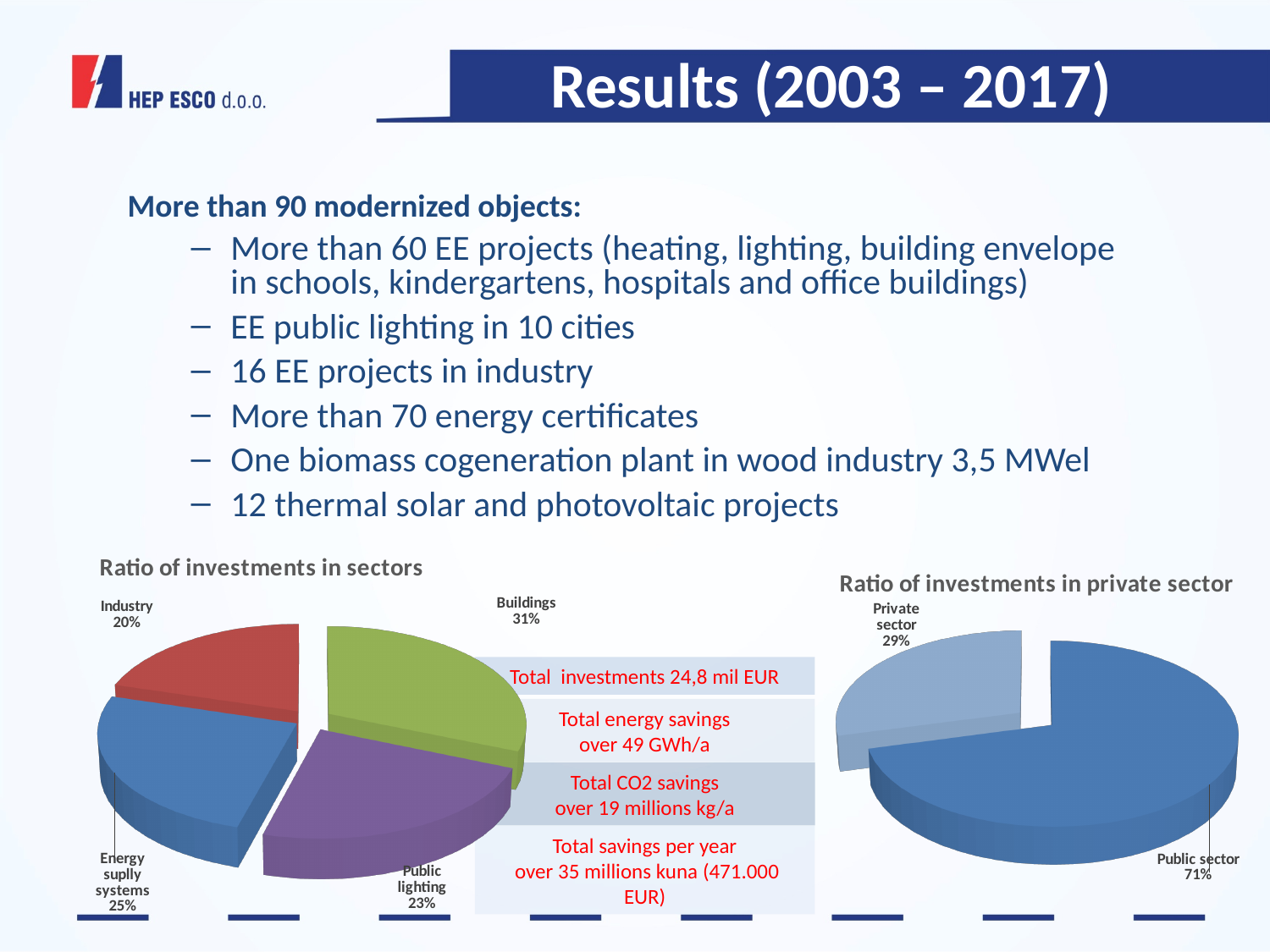
In the 'Ratio of investments in sectors' chart, what share does Public lighting have? 23% In the 'Ratio of investments in sectors' chart, which is larger: Energy supply systems or Public lighting? Energy supply systems In the 'Ratio of investments in sectors' chart, which sector has the largest share? Buildings What type of chart is the 'Ratio of investments in private sector' chart? Pie chart In the 'Ratio of investments in sectors' chart, what share does Industry have? 20% In the 'Ratio of investments in sectors' chart, how many sectors are shown? 4 In the 'Ratio of investments in sectors' chart, what is the difference between the Buildings share and the Industry share? 11 percentage points In the 'Ratio of investments in sectors' chart, which sector has the smallest share? Industry In the 'Ratio of investments in private sector' chart, how many slices are there? 2 In the 'Ratio of investments in private sector' chart, what share does the Public sector have? 71% In the 'Ratio of investments in sectors' chart, what share do Buildings have? 31% In the 'Ratio of investments in private sector' chart, what share does the Private sector have? 29%